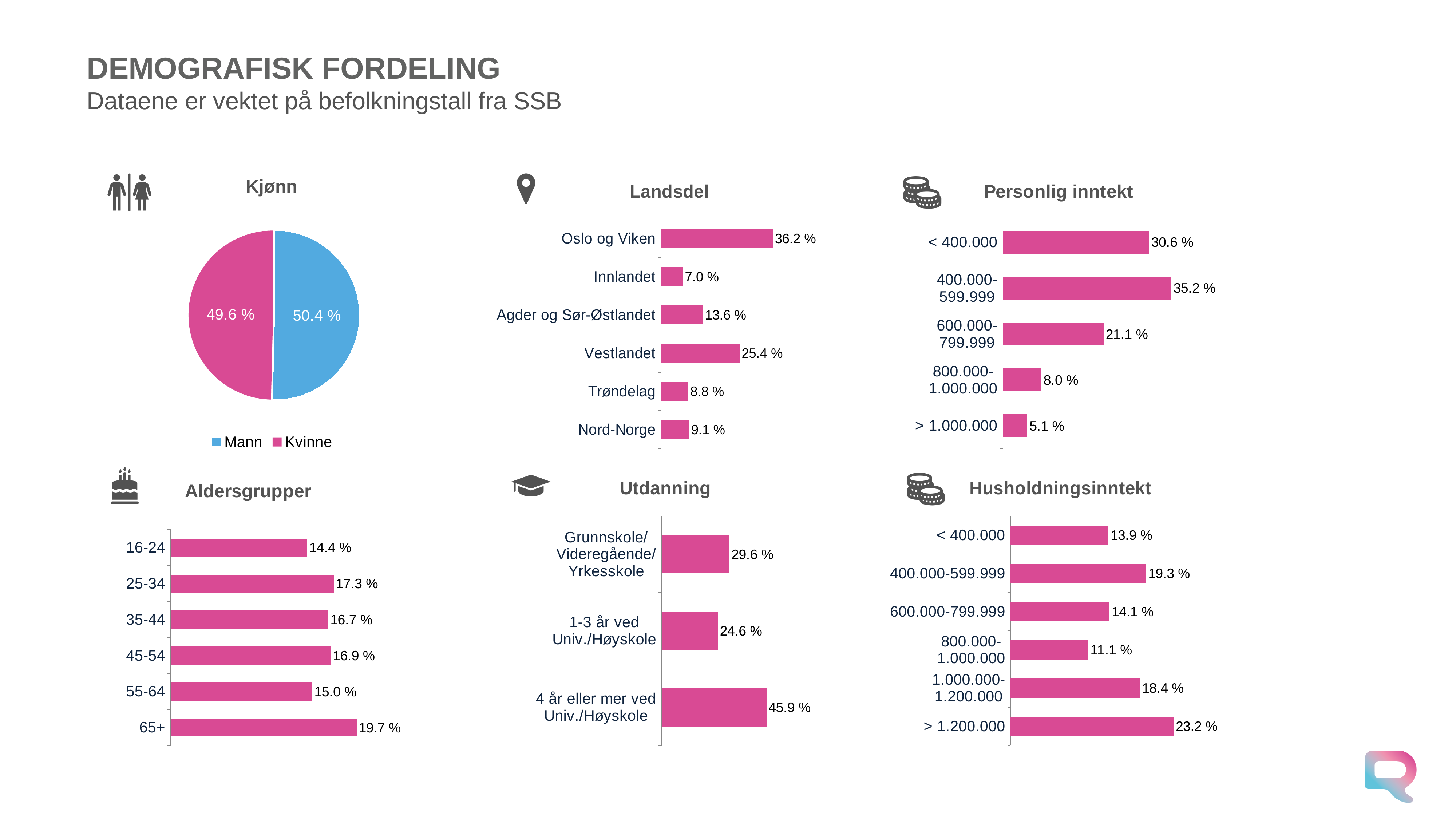
In the Landsdel chart, what is the value for Vestlandet? 25.4 % In the Landsdel chart, which category has the highest value? Oslo og Viken How many categories does the Aldersgrupper chart show? 6 In the Aldersgrupper chart, which age group has the highest value? 65+ In the Utdanning chart, what is the value for 4 år eller mer ved Univ./Høyskole? 45.9 % In the Personlig inntekt chart, what is the difference between 400.000-599.999 and < 400.000? 4.6 % In the Landsdel chart, which category has the lowest value? Innlandet In the Kjønn chart, what share is Mann? 50.4 % What kind of chart is the Kjønn chart? pie chart In the Personlig inntekt chart, what is the value for > 1.000.000? 5.1 % What kind of chart is the Husholdningsinntekt chart? bar chart In the Husholdningsinntekt chart, which is larger: 400.000-599.999 or 1.000.000-1.200.000? 400.000-599.999